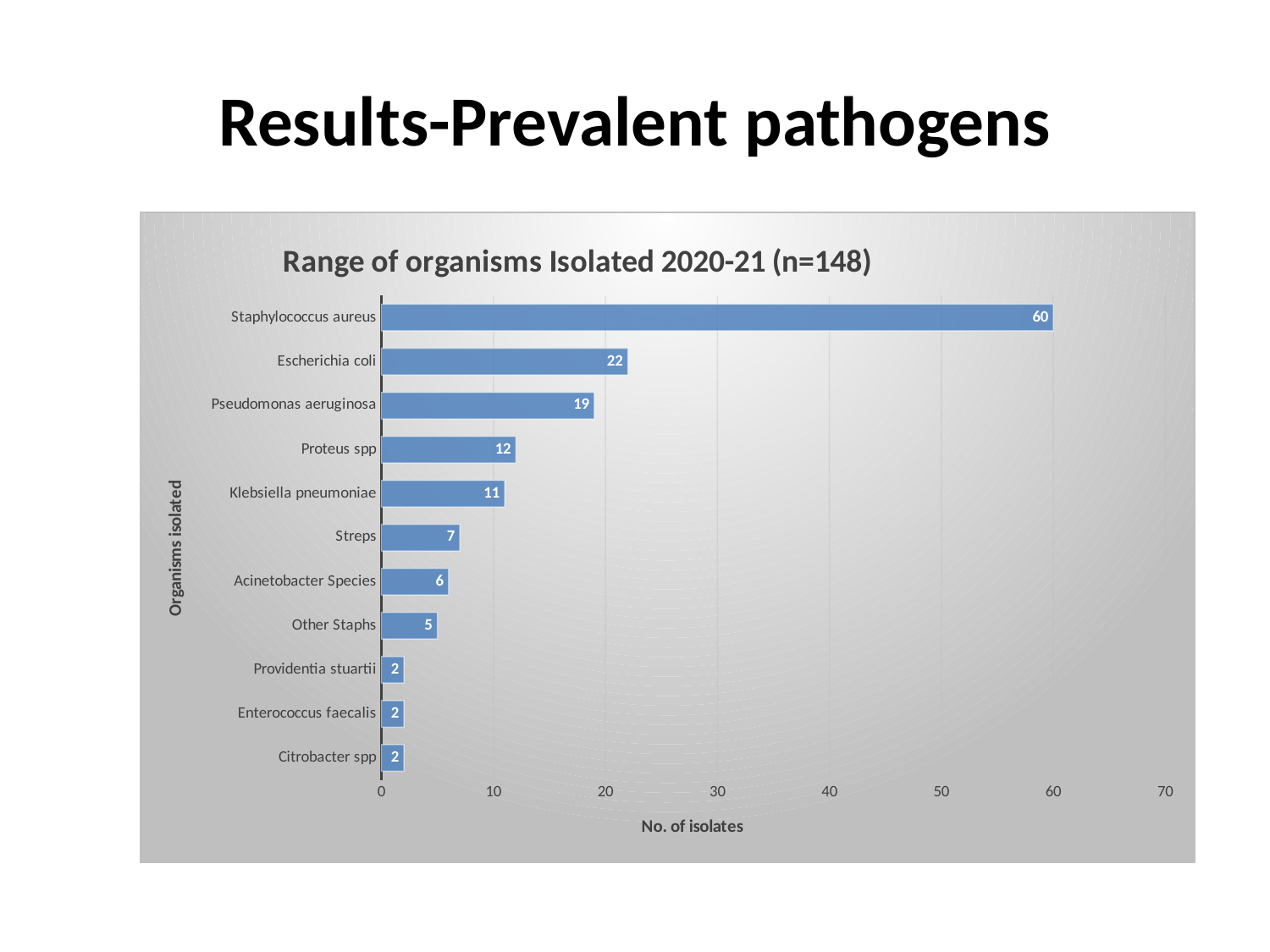
What is the difference in isolates between Staphylococcus aureus and Escherichia coli? 38 What kind of chart is shown on the slide? Bar chart What is the title of the chart? Range of organisms Isolated 2020-21 (n=148) What is the label of the horizontal axis? No. of isolates What is the number of isolates for Pseudomonas aeruginosa? 19 Which has more isolates, Acinetobacter Species or Other Staphs? Acinetobacter Species Is the value for Escherichia coli greater or less than 20? greater How many organisms are shown on the chart? 11 What is the difference in isolates between Proteus spp and Streps? 5 Which organism has the highest number of isolates? Staphylococcus aureus What is the number of isolates for Staphylococcus aureus? 60 What is the number of isolates for Klebsiella pneumoniae? 11